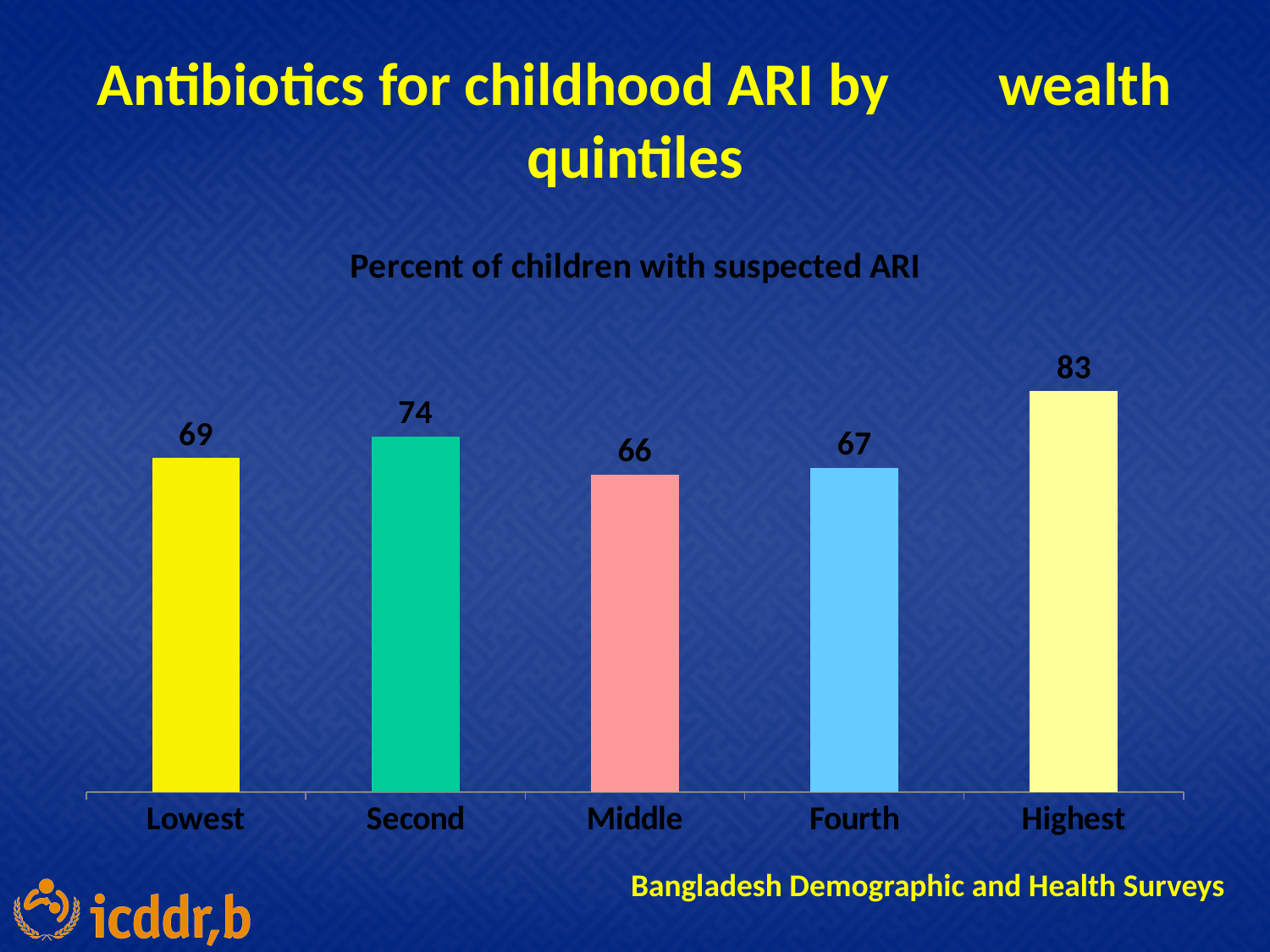
What is the value for the Highest wealth quintile? 83 What is the value for the Lowest wealth quintile? 69 What kind of chart is shown on the slide? Bar chart What is the value for the Second wealth quintile? 74 What is the value for the Middle wealth quintile? 66 Which wealth quintile has the highest value? Highest Which is larger, the value for the Second quintile or the value for the Fourth quintile? Second How many wealth quintiles are shown on the chart? 5 What is the difference between the values for the Second and Middle quintiles? 8 What is the difference between the values for the Highest and Lowest quintiles? 14 What is the chart's subtitle describing the measure plotted? Percent of children with suspected ARI Which wealth quintile has the lowest value? Middle